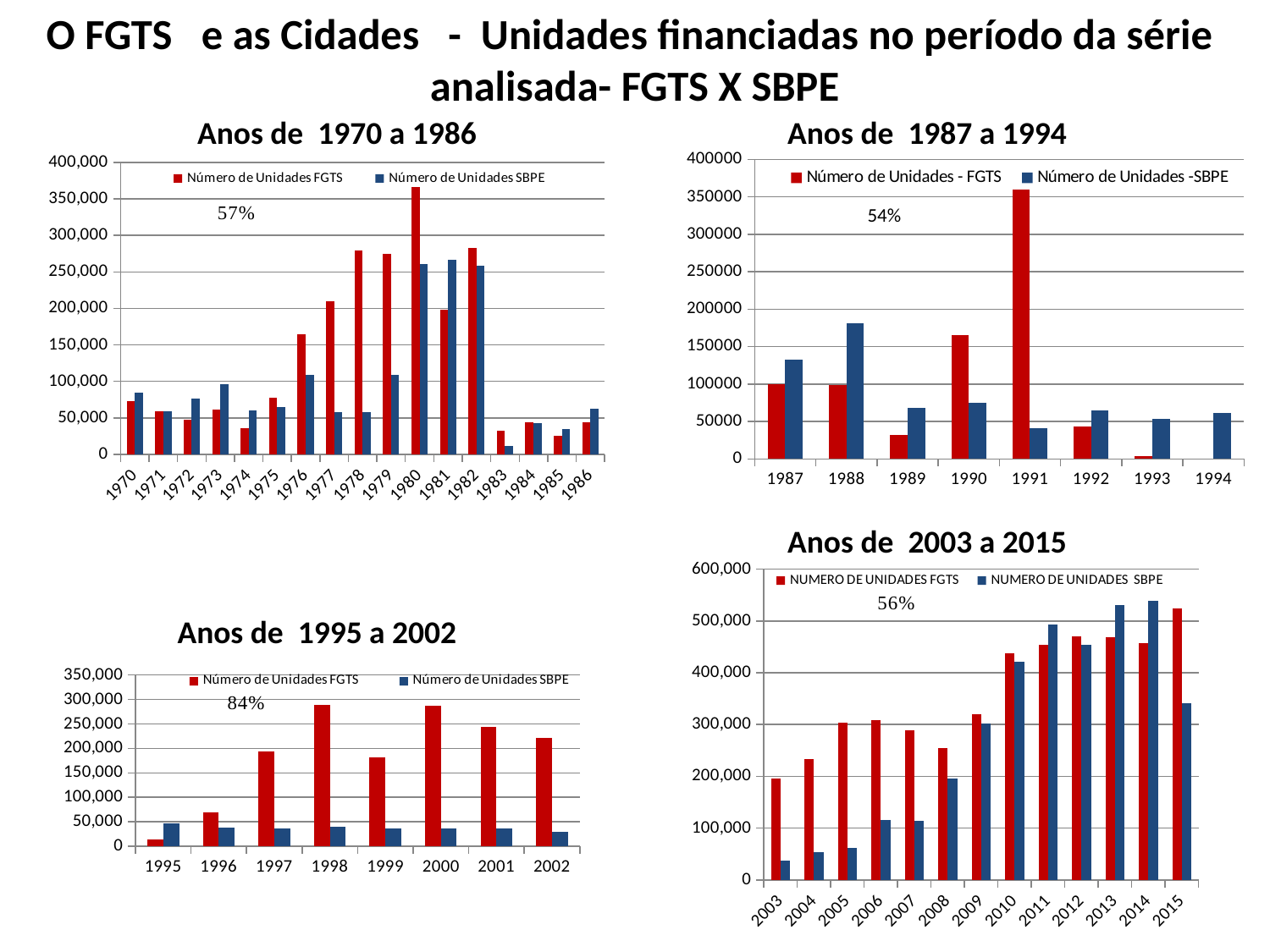
How many years are shown on the x axis of the 'Anos de 1970 a 1986' chart? 17 In the 'Anos de 2003 a 2015' chart, which year has the lowest value for NUMERO DE UNIDADES SBPE? 2003 How many series does the legend list in the 'Anos de 2003 a 2015' chart? 2 In the 'Anos de 1970 a 1986' chart, which year has the highest value for Número de Unidades FGTS? 1980 In the 'Anos de 1995 a 2002' chart, is the value for Número de Unidades FGTS in 1998 greater or less than 250,000? greater In the 'Anos de 1987 a 1994' chart, which year has the highest value for Número de Unidades - FGTS? 1991 In the 'Anos de 1987 a 1994' chart, which year has the highest value for Número de Unidades -SBPE? 1988 In the 'Anos de 1995 a 2002' chart, which year has the lowest value for Número de Unidades FGTS? 1995 In the 'Anos de 1987 a 1994' chart, which is larger in 1988: Número de Unidades - FGTS or Número de Unidades -SBPE? Número de Unidades -SBPE In the 'Anos de 1970 a 1986' chart, is the value for Número de Unidades FGTS in 1980 greater or less than 350,000? greater What type of chart is used in the 'Anos de 1970 a 1986' chart? Bar chart What percentage label is shown inside the 'Anos de 1995 a 2002' chart? 84%